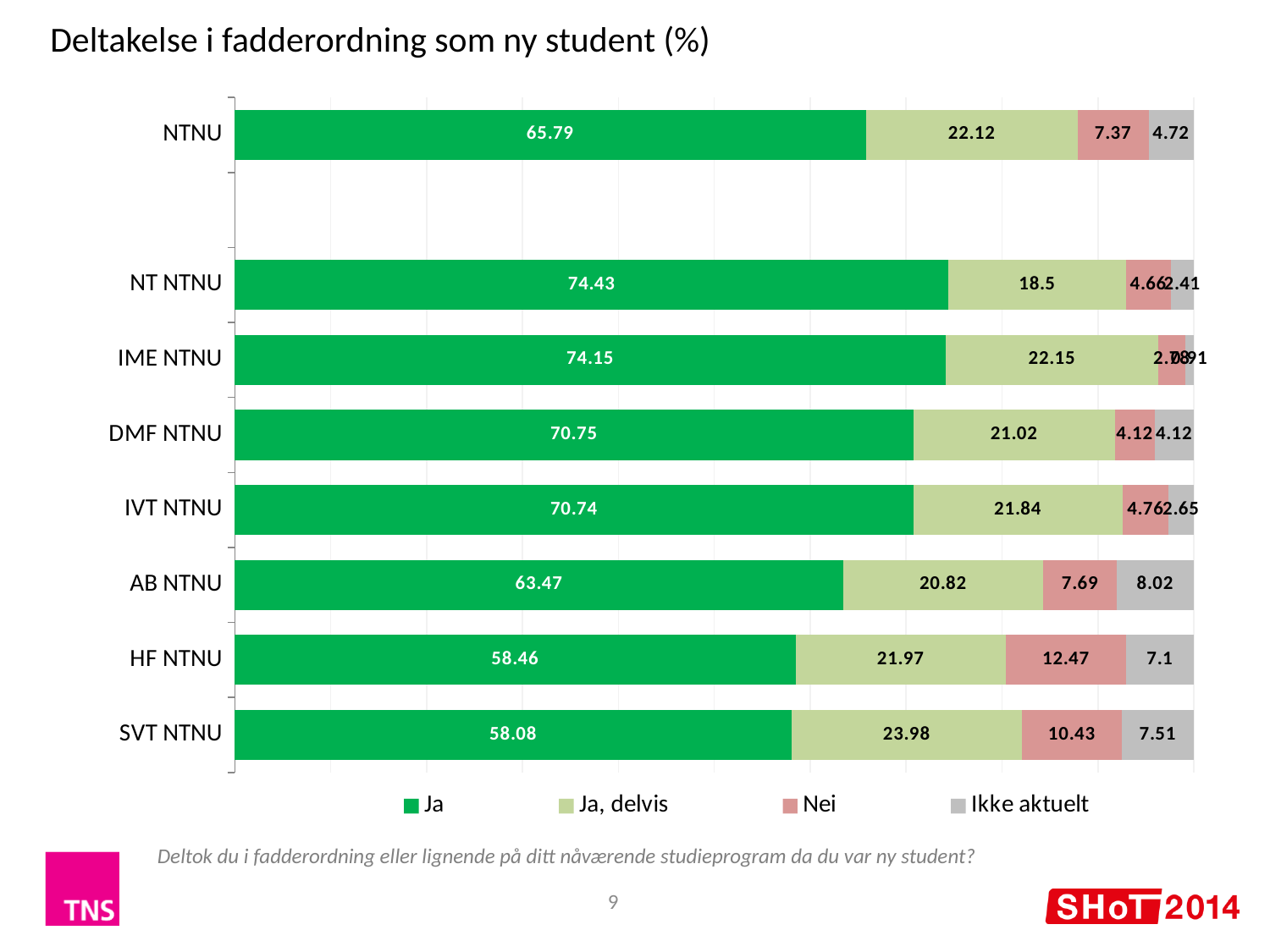
What is the title of the chart? Deltakelse i fadderordning som ny student (%) What kind of chart is shown? Stacked bar chart Which is larger, the "Ja" value for DMF NTNU or for AB NTNU? DMF NTNU Which category has the highest value for "Ja"? NT NTNU What is the difference between the "Nei" values for HF NTNU and SVT NTNU? 2.04 What is the value of "Ja, delvis" for SVT NTNU? 23.98 What is the value of "Ikke aktuelt" for AB NTNU? 8.02 How many series does the legend list? 4 What is the value of "Ja" for NTNU? 65.79 What is the value of "Nei" for HF NTNU? 12.47 How many categories are shown on the y axis? 8 Which category has the highest value for "Nei"? HF NTNU